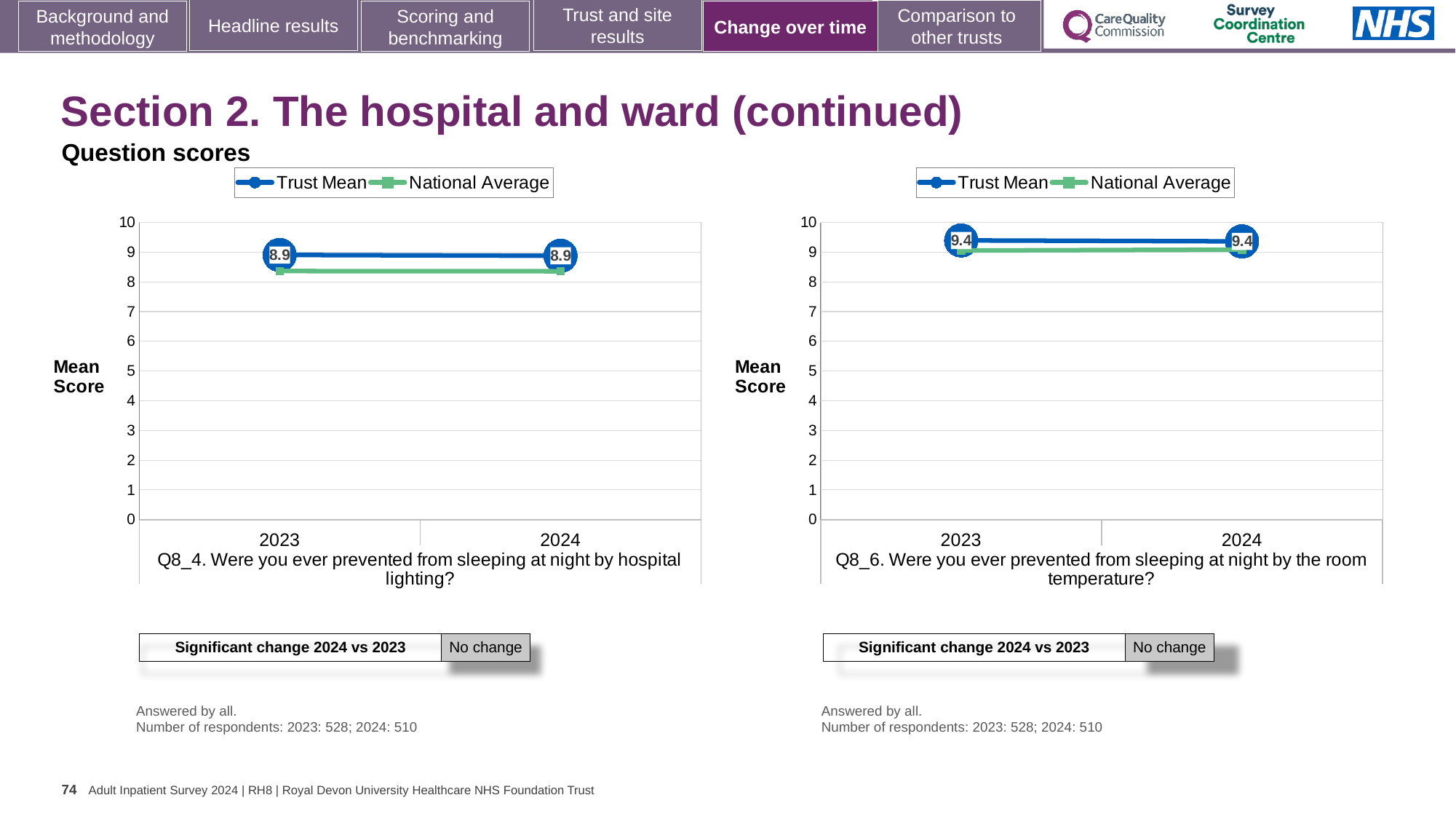
What kind of chart is the Q8_4 hospital lighting chart on the left? Line chart In the Q8_6 room temperature chart on the right, what is the Trust Mean score for 2024? 9.4 In the Q8_4 hospital lighting chart on the left, does the Trust Mean rise, fall or stay the same from 2023 to 2024? Stays the same In the Q8_4 hospital lighting chart on the left, what is the Trust Mean score for 2023? 8.9 In the Q8_6 room temperature chart on the right, what is the Trust Mean score for 2023? 9.4 In the Q8_4 hospital lighting chart on the left, which is higher in 2024, the Trust Mean or the National Average? Trust Mean In the Q8_4 hospital lighting chart on the left, is the National Average for 2023 greater or less than 8? greater What does the 'Significant change 2024 vs 2023' box under the Q8_6 room temperature chart on the right say? No change In the Q8_4 hospital lighting chart on the left, what is the Trust Mean score for 2024? 8.9 How many series does the legend of the Q8_6 room temperature chart on the right list? 2 How many years are plotted on the x axis of the Q8_4 hospital lighting chart on the left? 2 In the Q8_6 room temperature chart on the right, what is the difference between the Trust Mean for 2024 and for 2023? 0